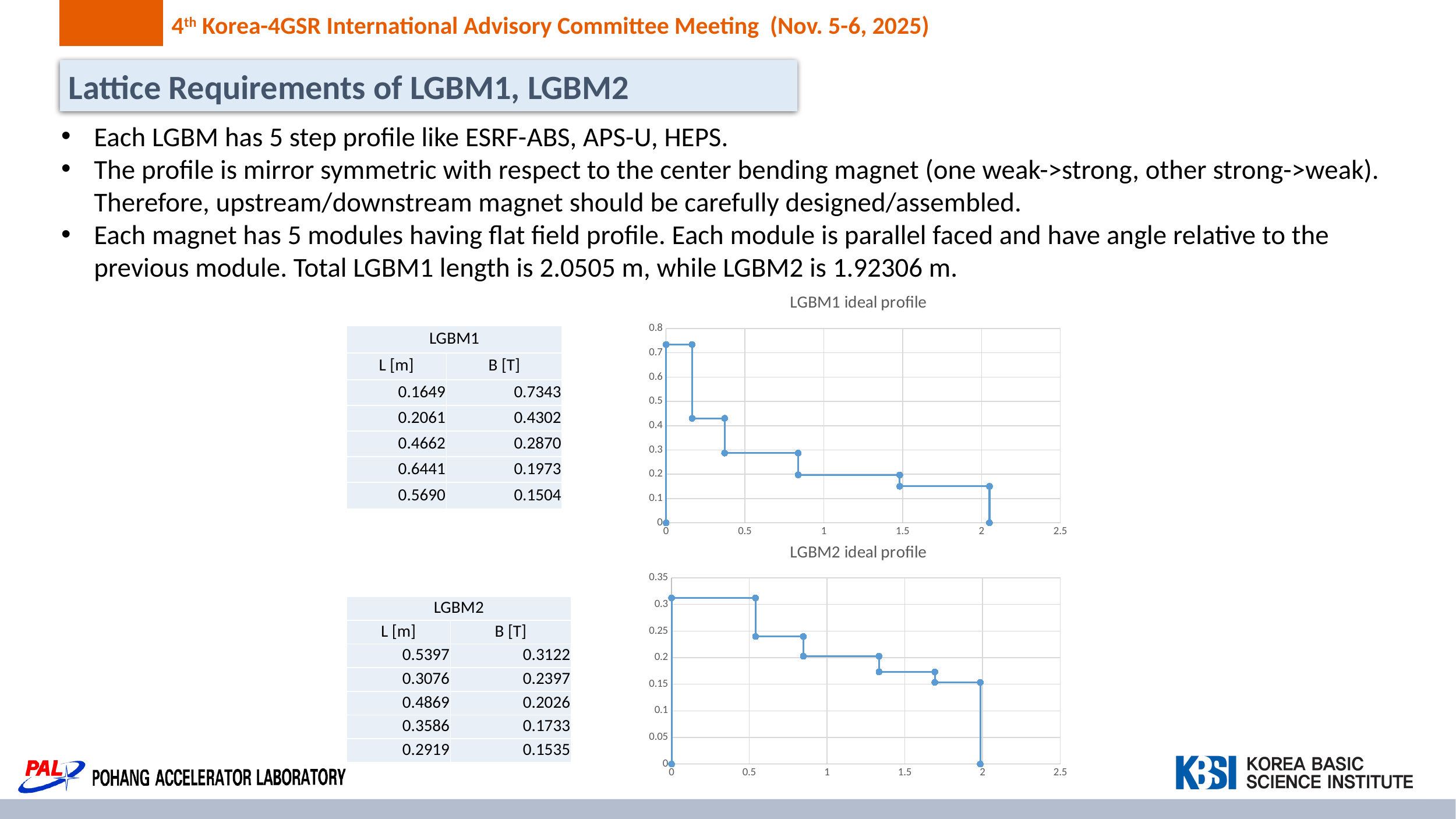
How many flat steps does the profile in the 'LGBM2 ideal profile' chart have? 5 In the 'LGBM2 ideal profile' chart, is the value of the first step (starting at x = 0) greater or less than 0.3? greater In the 'LGBM2 ideal profile' chart, do the values rise or fall as the x axis increases? fall What is the title of the upper chart on the slide? LGBM1 ideal profile How many flat steps does the profile in the 'LGBM1 ideal profile' chart have? 5 What is the maximum value shown on the y axis of the 'LGBM2 ideal profile' chart? 0.35 In the 'LGBM1 ideal profile' chart, is the value of the last step (ending near x = 2) greater or less than 0.2? less What kind of chart is the 'LGBM1 ideal profile' chart? line chart In the 'LGBM1 ideal profile' chart, do the values rise or fall as the x axis increases? fall In the 'LGBM1 ideal profile' chart, which step has the highest value: the first step or the last step? the first step In the 'LGBM1 ideal profile' chart, is the value of the first step (starting at x = 0) greater or less than 0.7? greater